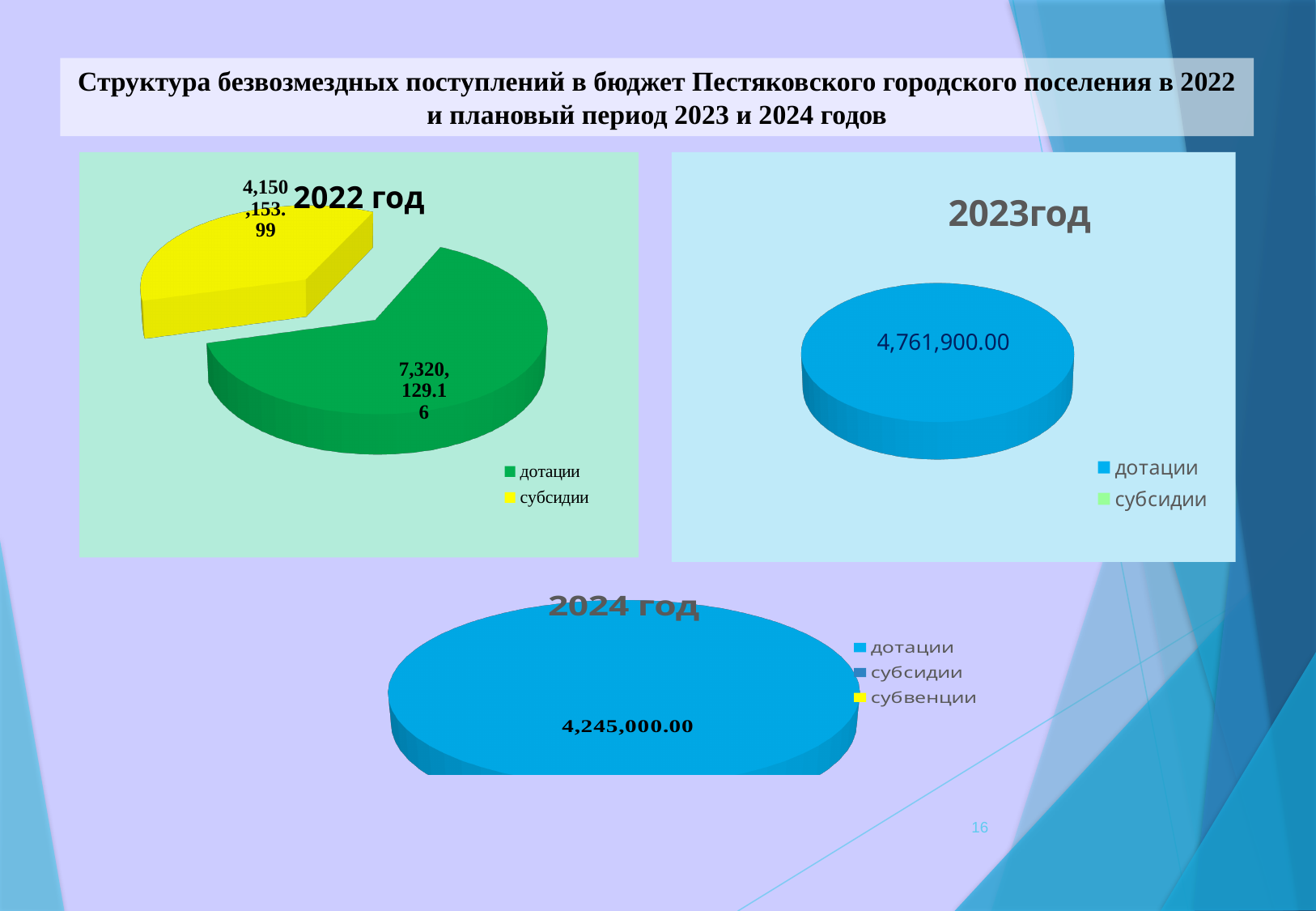
In the 2022 год chart, what colour represents субсидии? yellow In the 2022 год chart, what is the total of дотации and субсидии? 11,470,283.15 Which is larger: the дотации value in the 2023год chart or in the 2024 год chart? 2023год What type of chart is used for the 2022 год chart? pie chart In the 2022 год chart, what is the difference between дотации and субсидии? 3,169,975.17 In the 2022 год chart, which category has the largest slice? дотации In the 2024 год chart, what is the value shown on the pie? 4,245,000.00 In the 2022 год chart, which category has the smallest slice? субсидии How many entries does the legend of the 2024 год chart list? 3 In the 2022 год chart, what is the value for субсидии? 4,150,153.99 In the 2022 год chart, what is the value for дотации? 7,320,129.16 In the 2023год chart, what is the value shown on the pie? 4,761,900.00